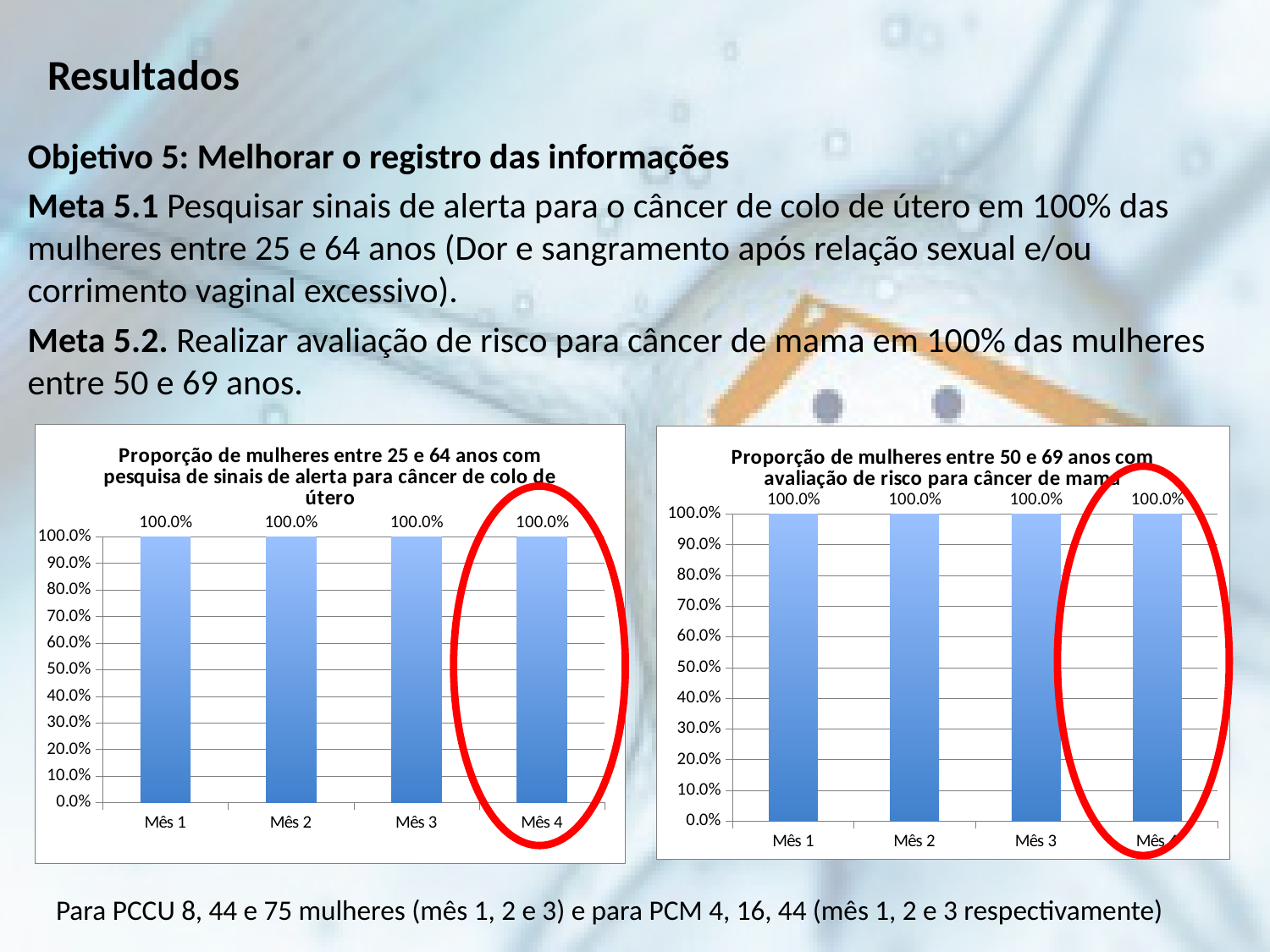
In the right chart (Proporção de mulheres entre 50 e 69 anos), do the values rise, fall or stay the same from Mês 1 to Mês 4? Stay the same In the left chart (Proporção de mulheres entre 25 e 64 anos), is the value for Mês 3 greater or less than 50.0%? greater In the left chart (Proporção de mulheres entre 25 e 64 anos), what is the difference between the values for Mês 2 and Mês 3? 0.0% What kind of chart is the left chart (Proporção de mulheres entre 25 e 64 anos)? Bar chart How many categories (months) are shown in the left chart (Proporção de mulheres entre 25 e 64 anos)? 4 In the left chart (Proporção de mulheres entre 25 e 64 anos), what is the value for Mês 1? 100.0% What is the title of the right chart? Proporção de mulheres entre 50 e 69 anos com avaliação de risco para câncer de mama In the right chart (Proporção de mulheres entre 50 e 69 anos), what is the value for Mês 2? 100.0% In the right chart (Proporção de mulheres entre 50 e 69 anos), what is the value for Mês 3? 100.0% In the left chart (Proporção de mulheres entre 25 e 64 anos), what is the value for Mês 4? 100.0% In the right chart (Proporção de mulheres entre 50 e 69 anos), what is the difference between the values for Mês 1 and Mês 4? 0.0% How many bars are shown in the right chart (Proporção de mulheres entre 50 e 69 anos)? 4